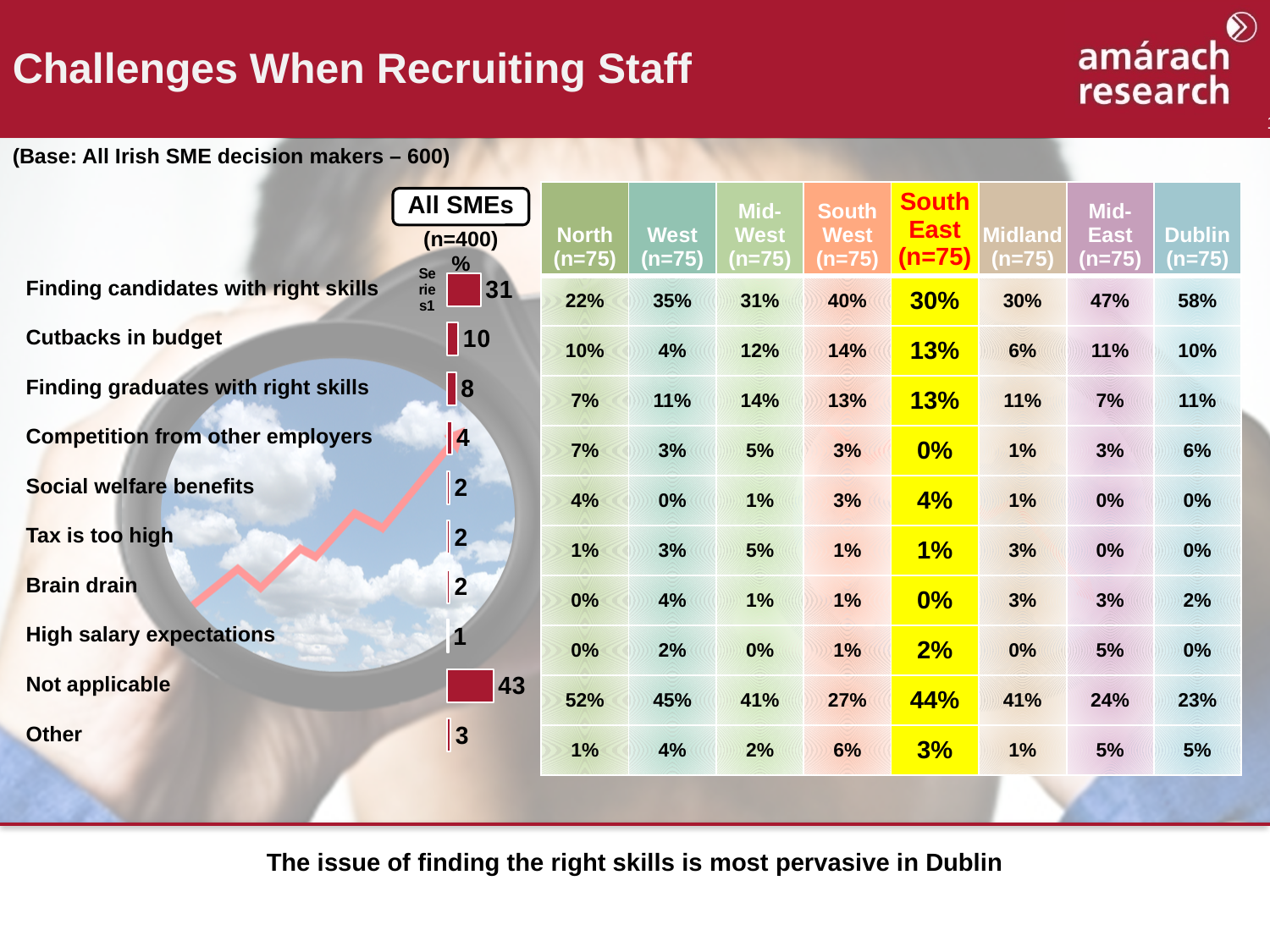
How many categories are shown in the All SMEs bar chart? 10 What is the value for 'Finding graduates with right skills' in the All SMEs bar chart? 8 In the All SMEs bar chart, which is larger: 'Cutbacks in budget' or 'Finding graduates with right skills'? Cutbacks in budget In the All SMEs bar chart, what is the difference between 'Not applicable' and 'Finding candidates with right skills'? 12 Which category has the highest value in the All SMEs bar chart? Not applicable In the All SMEs bar chart, what is the difference between 'Competition from other employers' and 'Other'? 1 Which category has the lowest value in the All SMEs bar chart? High salary expectations What is the value for 'Finding candidates with right skills' in the All SMEs bar chart? 31 What is the base size shown for the All SMEs bar chart? n=400 What is the value for 'Not applicable' in the All SMEs bar chart? 43 What is the value for 'Cutbacks in budget' in the All SMEs bar chart? 10 What type of chart is used to show the All SMEs results? Bar chart